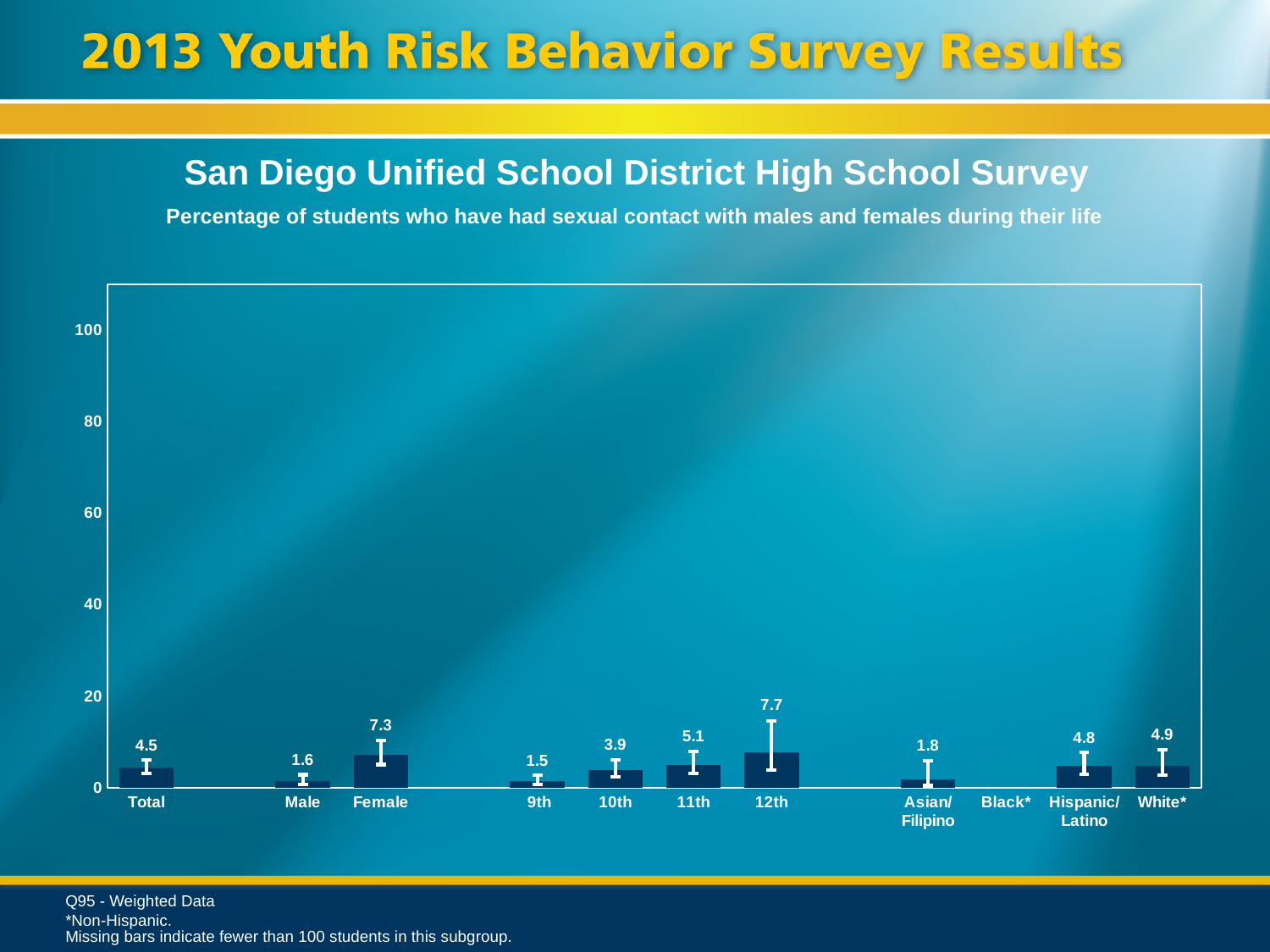
Do the values rise or fall from 9th to 12th grade? rise Which category has the lowest value among those with a bar shown? 9th Which category has no bar shown? Black* What is the value for Total? 4.5 What is the difference between the Female and Male values? 5.7 What is the value for Asian/Filipino? 1.8 Which category has the highest value? 12th Which is larger, the value for Hispanic/Latino or the value for White*? White* What is the value for Female? 7.3 Is the value for 12th greater or less than 20? less What kind of chart is shown? bar chart What is the value for 12th? 7.7